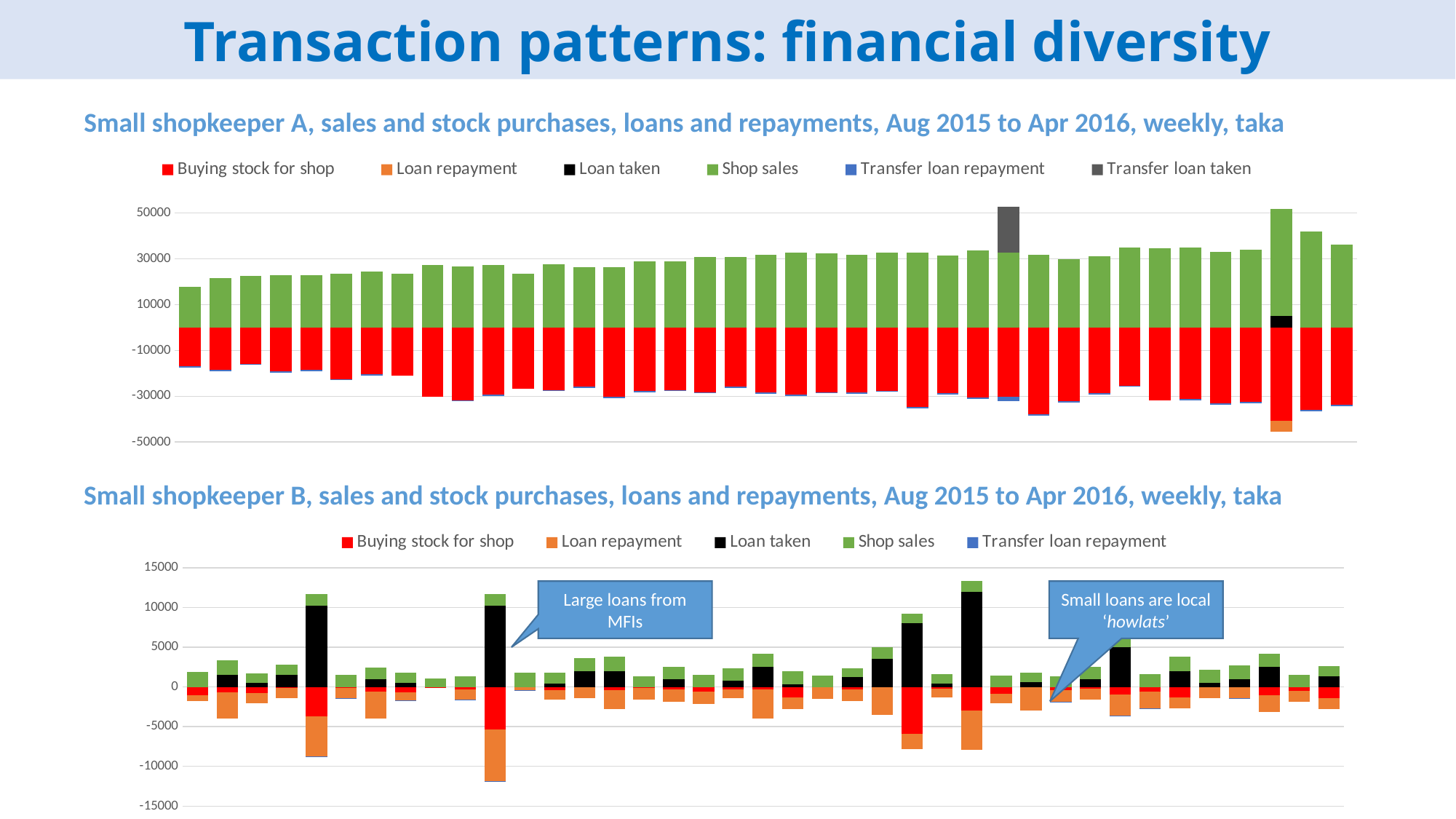
How many series does the legend of the 'Small shopkeeper B' chart list? 5 Which legend entry appears in the 'Small shopkeeper A' chart but not in the 'Small shopkeeper B' chart? Transfer loan taken How many series does the legend of the 'Small shopkeeper A' chart list? 6 In the 'Small shopkeeper B' chart, which series has the largest single positive bar? Loan taken What kind of chart is the 'Small shopkeeper A' chart at the top of the slide? Stacked bar chart In the 'Small shopkeeper B' chart, is the tallest Loan taken bar greater or less than 10000? greater In the 'Small shopkeeper A' chart, do the Shop sales values generally rise or fall from left to right? Rise In the 'Small shopkeeper A' chart, is the first Shop sales bar on the left greater or less than 30000? less What is the highest value shown on the vertical axis of the 'Small shopkeeper B' chart? 15000